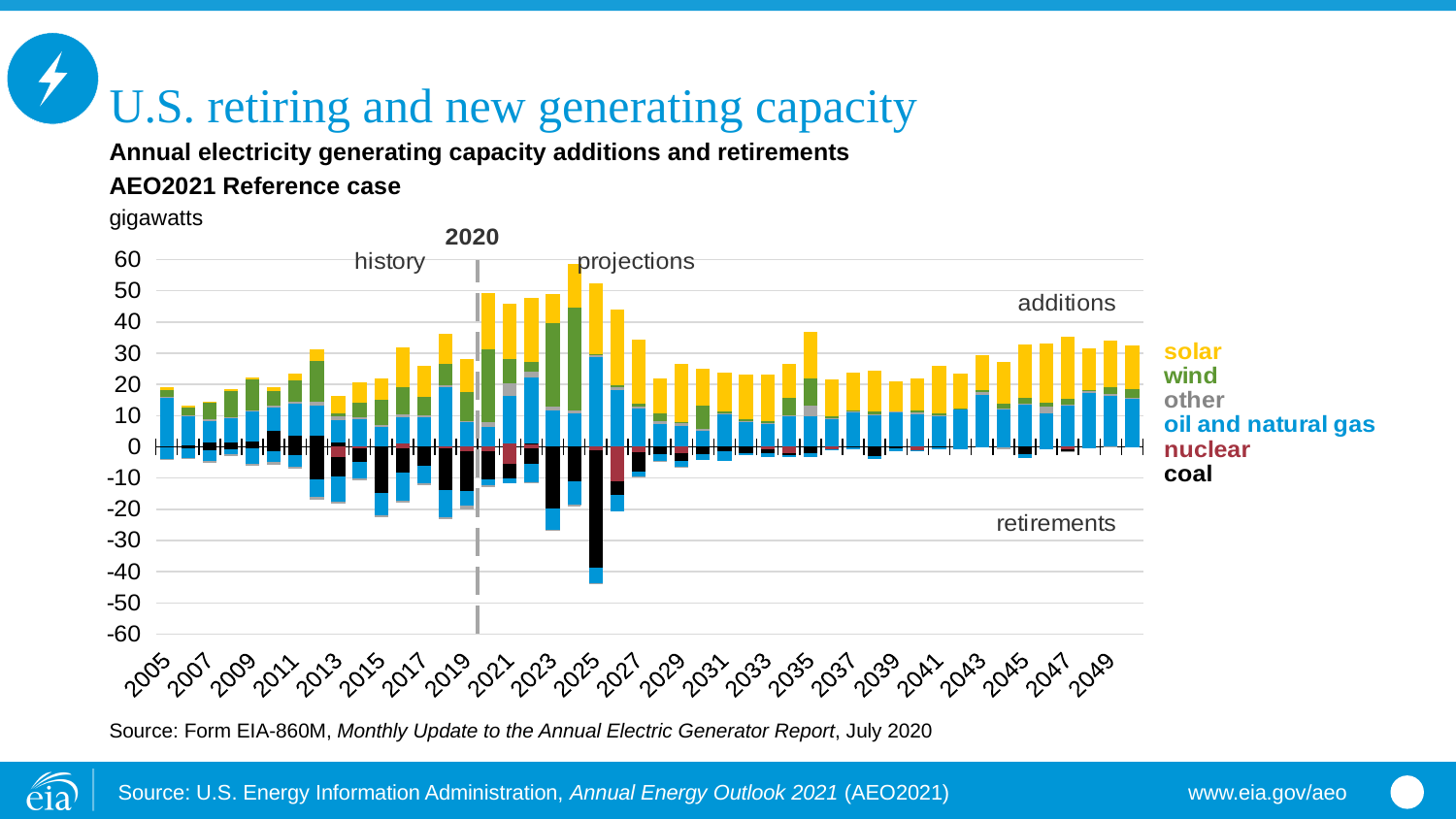
How many series does the legend list? 6 Which year has larger total additions, 2024 or 2030? 2024 Are the total additions in 2035 greater or less than 30 gigawatts? greater Are the total retirements in 2025 greater or less than -30 gigawatts? less Which year has the highest total capacity additions? 2024 What kind of chart is shown on the slide? stacked bar chart Which year has the largest total capacity retirements (the lowest bar)? 2025 Are the total additions in 2021 greater or less than 40 gigawatts? greater Which year marks the boundary between history and projections on the chart? 2020 Which series is shown in yellow in the legend? solar